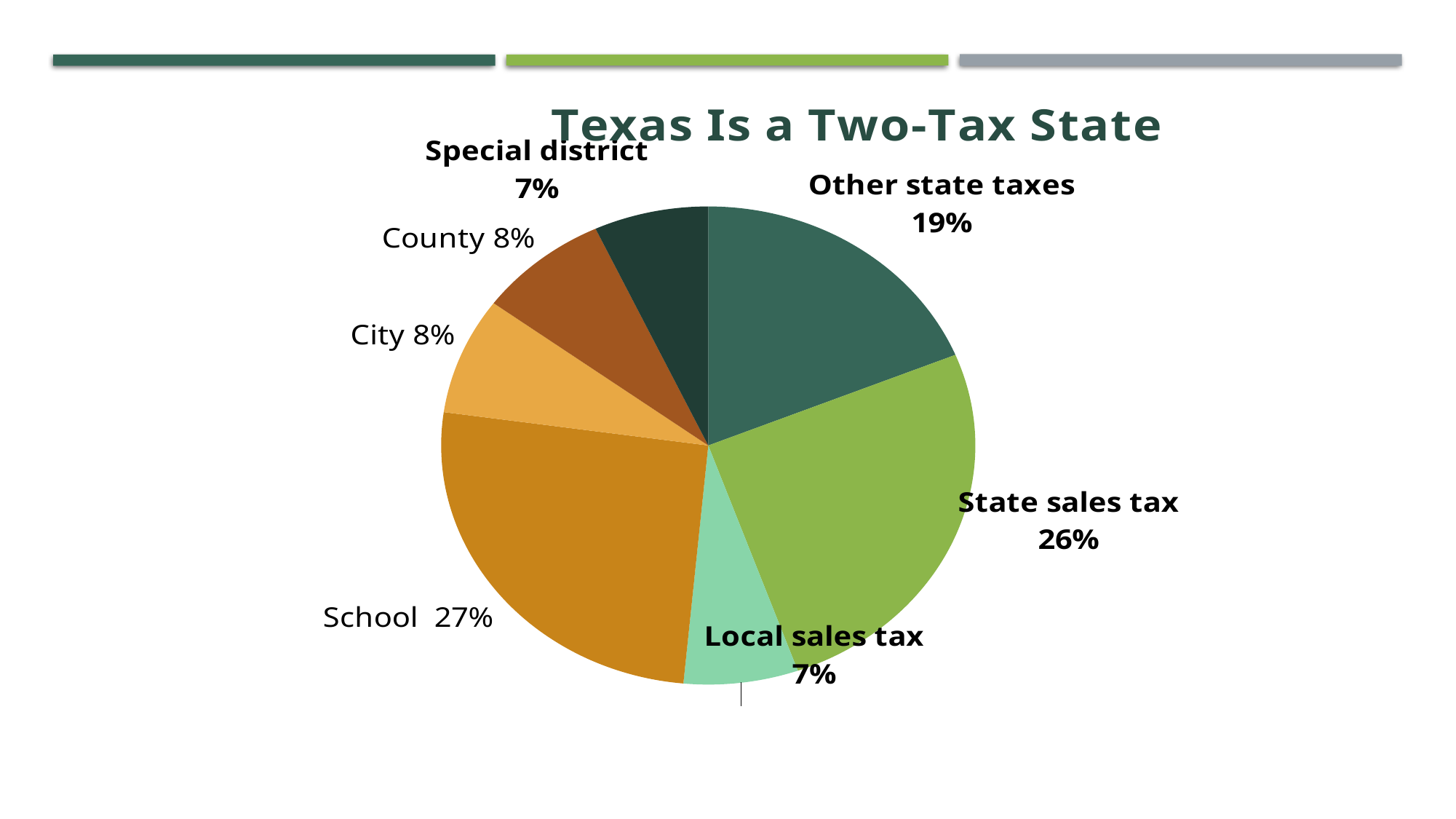
What share of the pie is School? 27% What is the difference between the School share and the Local sales tax share? 20% How many slices does the pie chart have? 7 Which slice is the largest in the pie chart? School What is the combined share of State sales tax and Local sales tax? 33% What share of the pie is State sales tax? 26% What share of the pie is Local sales tax? 7% What kind of chart is shown on the slide? Pie chart Which is larger, State sales tax or Other state taxes? State sales tax What share of the pie is County? 8% What share of the pie is Other state taxes? 19% What is the title of the chart? Texas Is a Two-Tax State